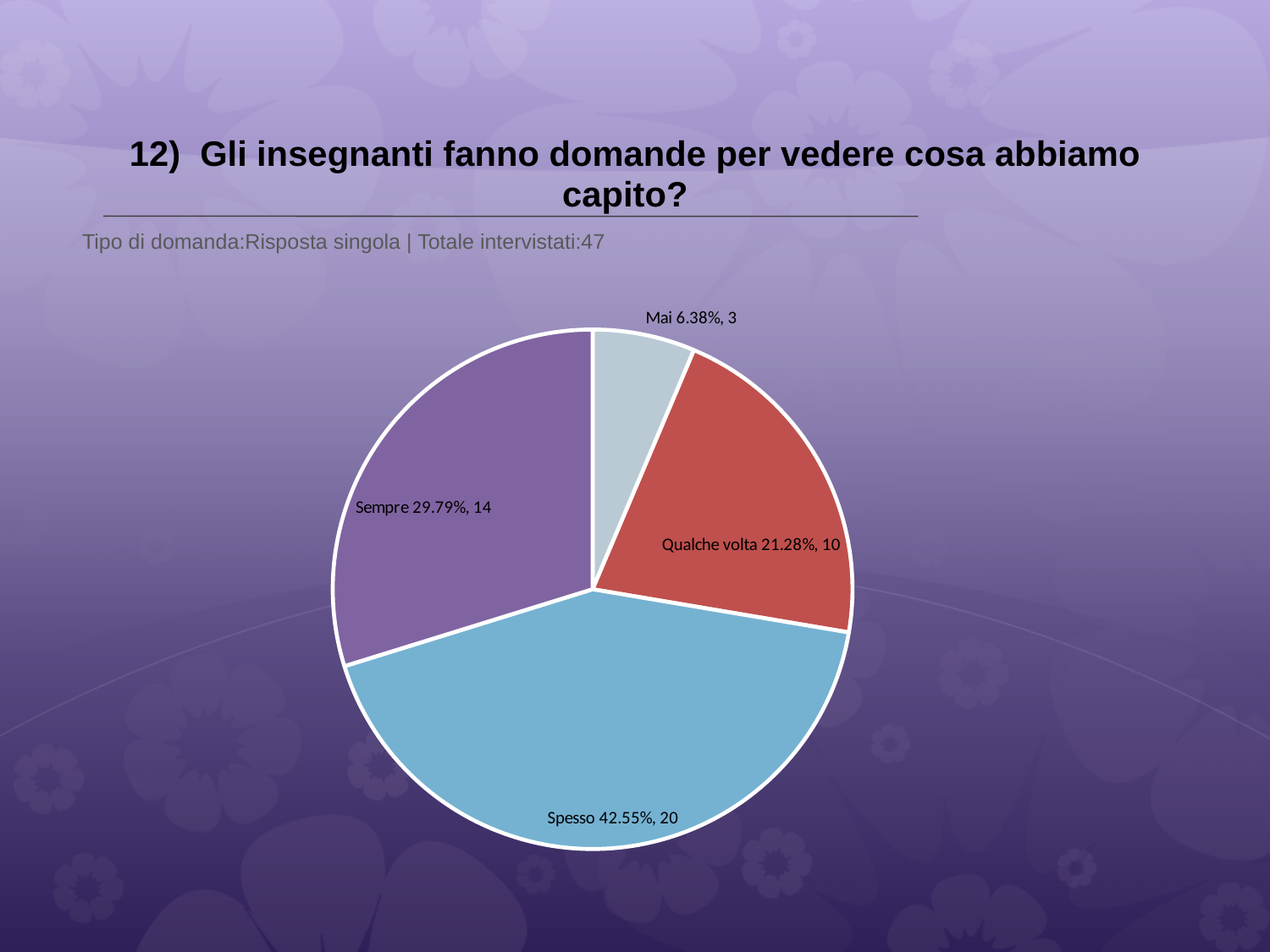
What is the difference in respondent count between 'Spesso' and 'Sempre'? 6 Which category has the smallest slice? Mai What percentage share does the 'Spesso' slice have? 42.55% What is the total number of respondents shown on the slide? 47 How many respondents answered 'Sempre'? 14 What colour is the 'Spesso' slice? blue How many slices does the pie chart have? 4 Which has more respondents, 'Qualche volta' or 'Sempre'? Sempre How many respondents answered 'Mai'? 3 What kind of chart is shown on the slide? pie chart Which category has the largest slice? Spesso What percentage share does the 'Qualche volta' slice have? 21.28%